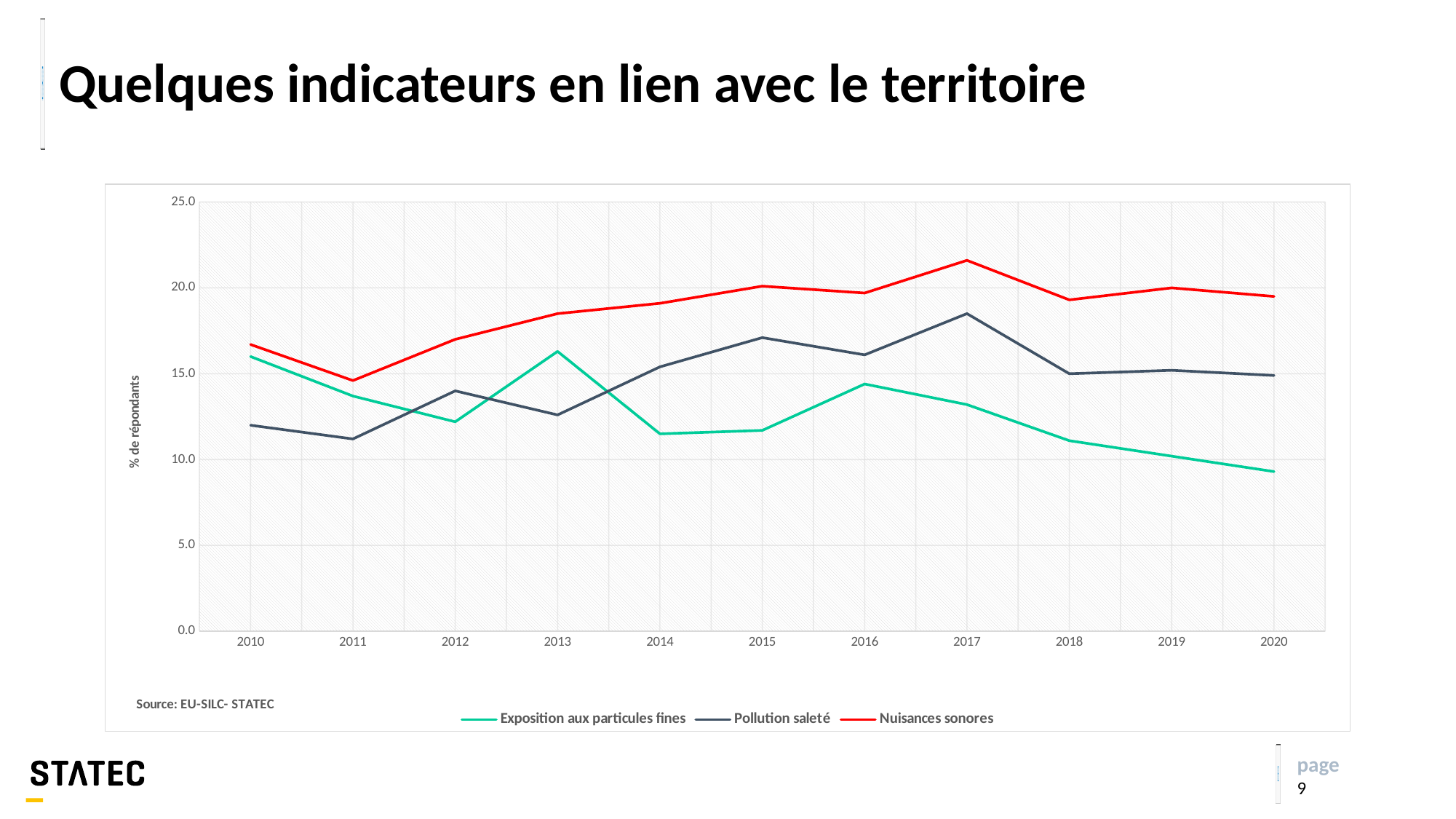
Is the value for Pollution saleté in 2017 greater or less than 20.0? less Is the value for Nuisances sonores in 2017 greater or less than 20.0? greater In which year does Nuisances sonores reach its highest value? 2017 Is the value for Exposition aux particules fines in 2020 greater or less than 10.0? less How many series does the legend list? 3 In which year does Nuisances sonores reach its lowest value? 2011 What kind of chart is shown on the slide? line chart Does Exposition aux particules fines rise or fall from 2016 to 2020? fall What is the label on the y axis? % de répondants In 2010, which is higher: Exposition aux particules fines or Pollution saleté? Exposition aux particules fines In which year does Exposition aux particules fines reach its lowest value? 2020 How many years are shown on the x axis? 11